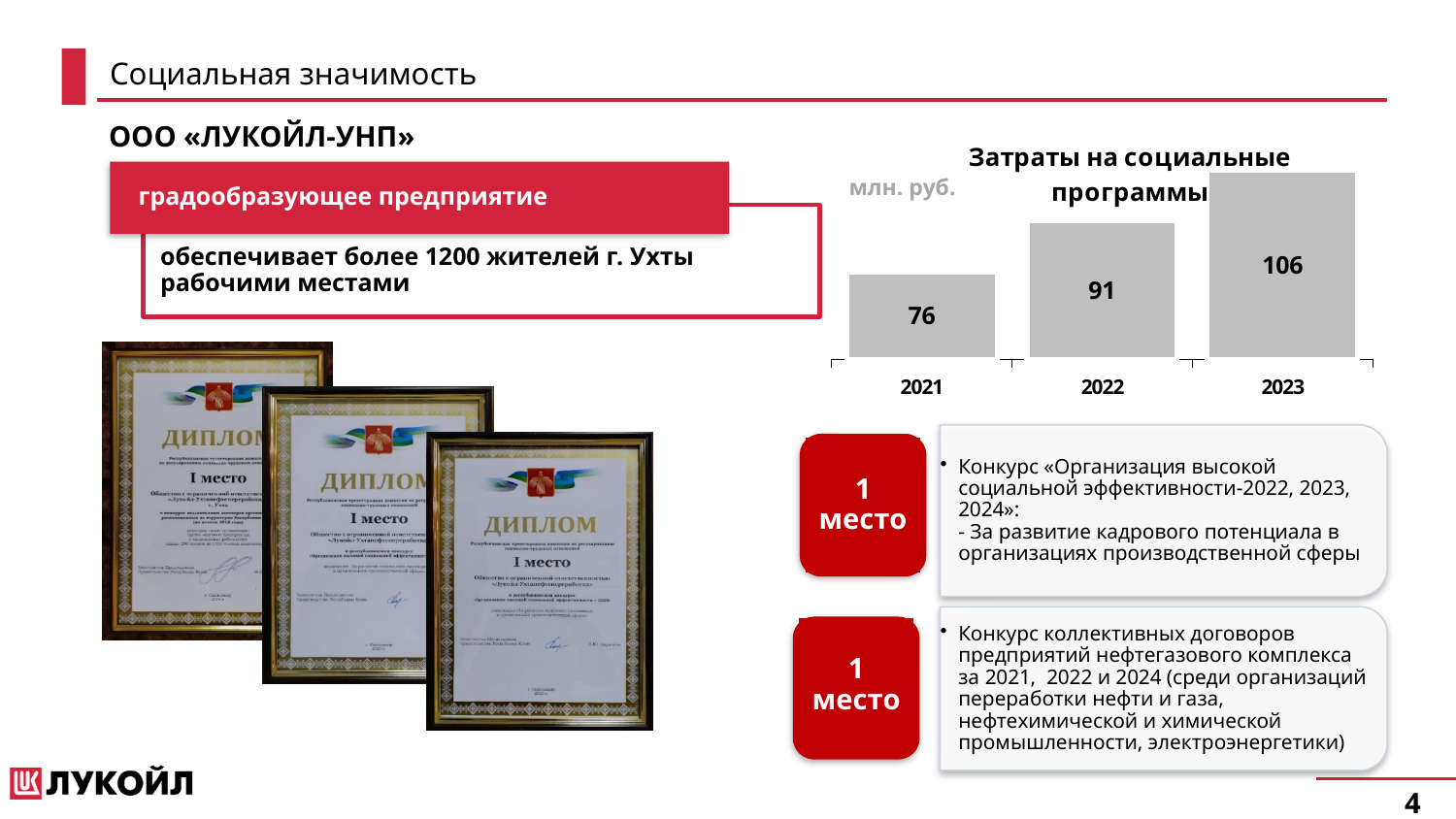
What is the difference between the values for 2023 and 2021 in the chart 'Затраты на социальные программы'? 30 What is the value for 2022 in the chart 'Затраты на социальные программы'? 91 What is the value for 2023 in the chart 'Затраты на социальные программы'? 106 What kind of chart is 'Затраты на социальные программы'? bar chart Do the values in the chart 'Затраты на социальные программы' rise or fall from 2021 to 2023? rise How many years are shown in the chart 'Затраты на социальные программы'? 3 Which year has the lowest value in the chart 'Затраты на социальные программы'? 2021 What unit is indicated for the values in the chart 'Затраты на социальные программы'? млн. руб. Which year has the highest value in the chart 'Затраты на социальные программы'? 2023 What is the value for 2021 in the chart 'Затраты на социальные программы'? 76 What is the difference between the values for 2022 and 2021 in the chart 'Затраты на социальные программы'? 15 In the chart 'Затраты на социальные программы', which is larger: the value for 2022 or the value for 2023? 2023